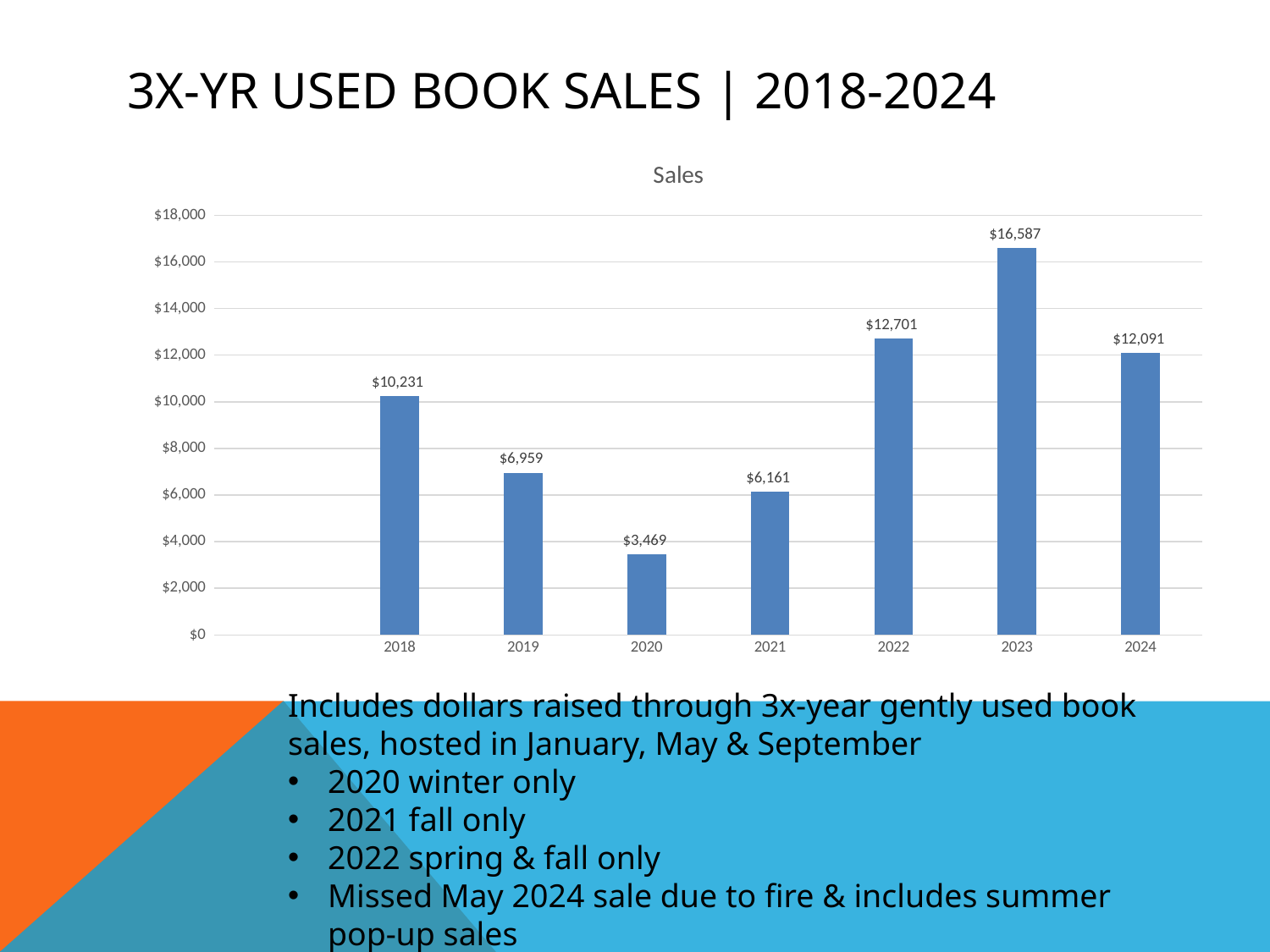
What were the sales in 2023? $16,587 What is the title of the chart? Sales Which year had the lowest sales? 2020 How many years are shown on the chart? 7 What is the difference in sales between 2023 and 2024? $4,496 Which year had higher sales, 2022 or 2024? 2022 Is the value for 2021 greater or less than $8,000? less What were the sales in 2018? $10,231 What were the sales in 2020? $3,469 Which year had the highest sales? 2023 What kind of chart is shown on the slide? bar chart What is the difference in sales between 2019 and 2021? $798